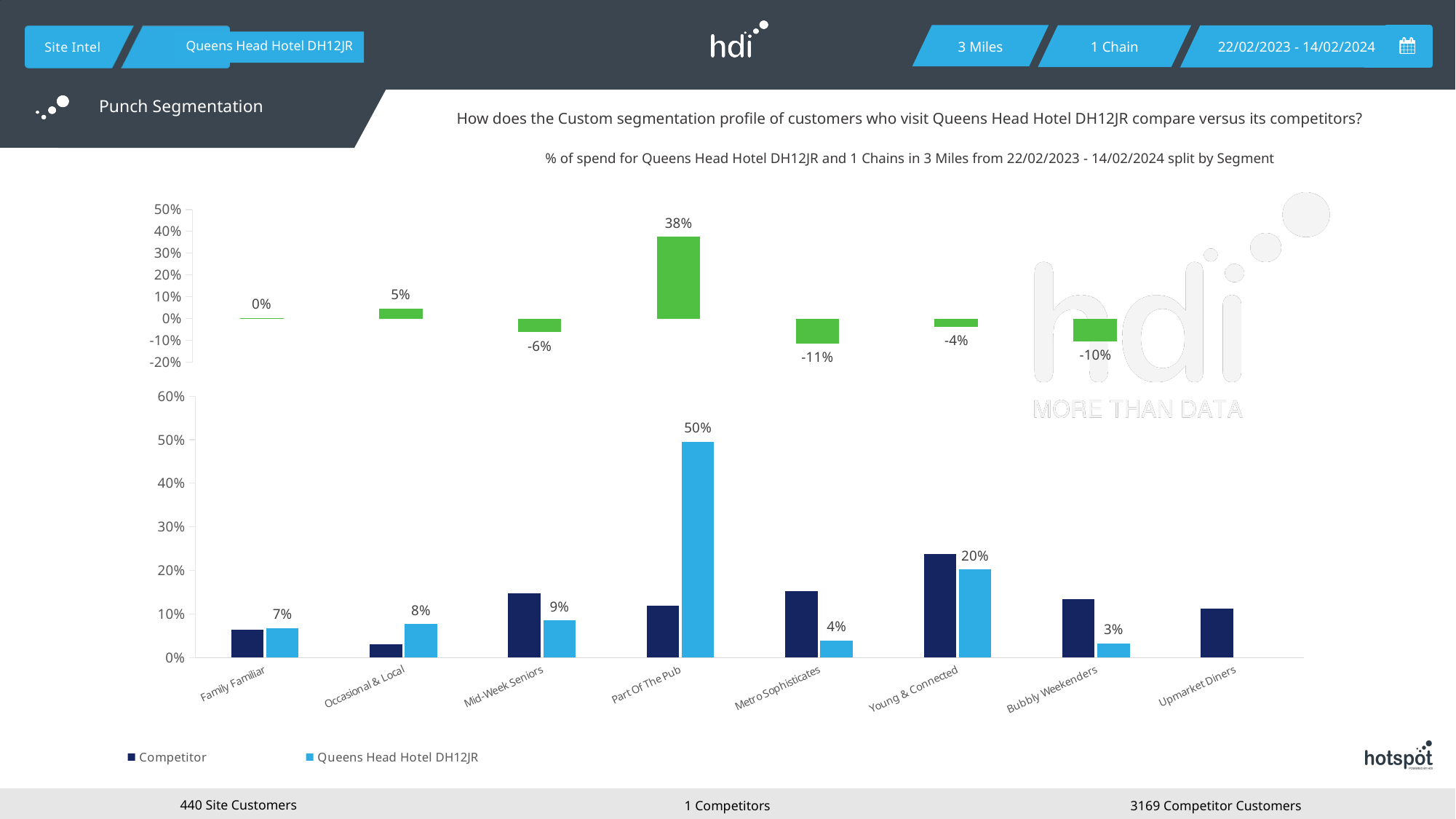
In the bottom chart, what is the value for Queens Head Hotel DH12JR in the Part Of The Pub segment? 50% In the bottom chart, what is the value for Queens Head Hotel DH12JR in the Young & Connected segment? 20% In the bottom chart, what is the difference between the Queens Head Hotel DH12JR values for Part Of The Pub and Young & Connected? 30 percentage points What kind of chart is the bottom chart? Bar chart In the top chart, what is the value shown for Occasional & Local? 5% How many series does the legend of the bottom chart list? 2 In the bottom chart, which segment has the highest value for Queens Head Hotel DH12JR? Part Of The Pub In the bottom chart, is the Competitor value for Young & Connected greater or less than 20%? greater In the bottom chart, for Mid-Week Seniors, which is larger: the Competitor value or the Queens Head Hotel DH12JR value? Competitor In the top chart, what is the value shown for Part Of The Pub? 38% In the top chart, what is the value shown for Metro Sophisticates? -11% In the top chart, which segment has the lowest value? Metro Sophisticates